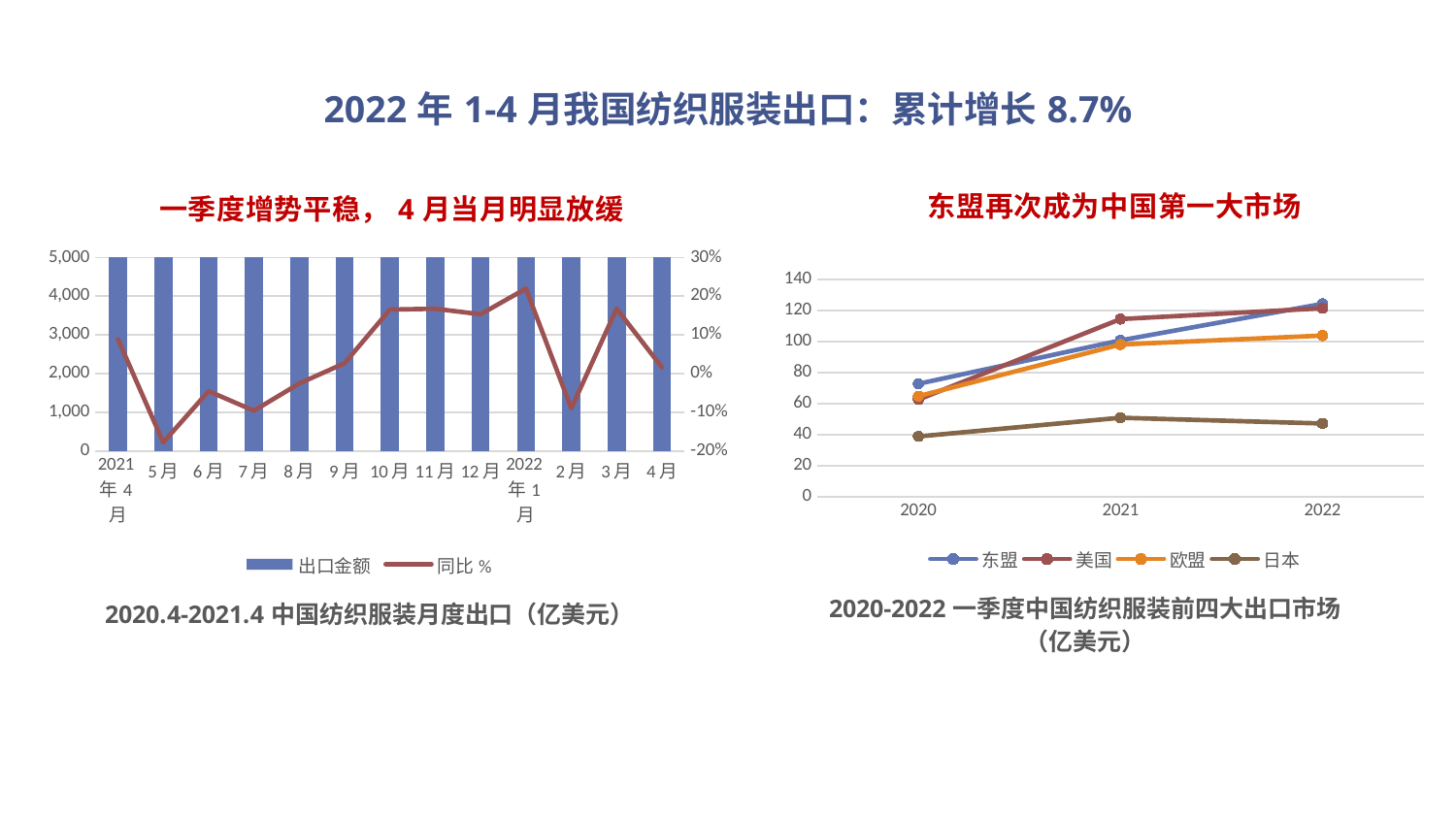
In the right-hand chart (东盟再次成为中国第一大市场), which is larger in 2020, 东盟 or 美国? 东盟 In the right-hand chart (东盟再次成为中国第一大市场), is the value for 美国 in 2021 greater or less than 100? greater How many series does the legend of the left-hand chart (一季度增势平稳，4月当月明显放缓) list? 2 How many years are plotted on the x axis of the right-hand chart (东盟再次成为中国第一大市场)? 3 In the right-hand chart (东盟再次成为中国第一大市场), is the value for 日本 in 2022 greater or less than 60? less In the right-hand chart (东盟再次成为中国第一大市场), does the 东盟 line rise or fall from 2020 to 2022? rise In the right-hand chart (东盟再次成为中国第一大市场), which market has the highest value in 2021? 美国 In the right-hand chart (东盟再次成为中国第一大市场), which market has the lowest value in 2022? 日本 How many series does the legend of the right-hand chart (东盟再次成为中国第一大市场) list? 4 In the left-hand chart (一季度增势平稳，4月当月明显放缓), is the 同比% value for 2022年1月 greater or less than 10%? greater In the left-hand chart (一季度增势平稳，4月当月明显放缓), which month has the lowest 同比% value? 5月 What kind of chart is the right-hand chart titled 东盟再次成为中国第一大市场? line chart